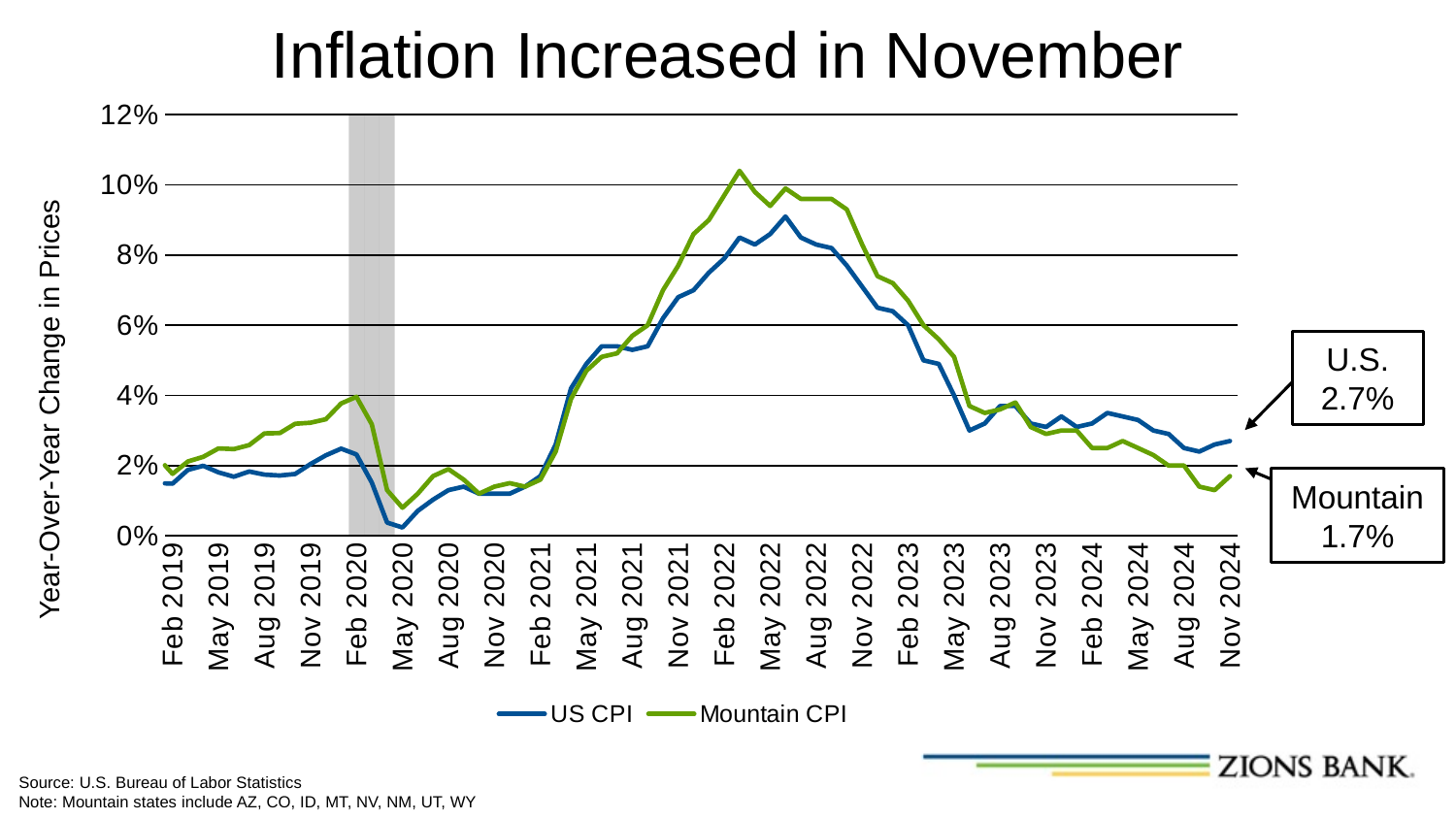
Is the peak value of the US CPI line in 2022 greater or less than 10%? less Which series reaches the higher peak on the chart? Mountain CPI Is the US CPI value around May 2020 greater or less than 2%? less How many series does the legend list? 2 What is the U.S. CPI value annotated for November 2024? 2.7% Is the peak value of the Mountain CPI line in early 2022 greater or less than 10%? greater In November 2024, which is higher, US CPI or Mountain CPI? US CPI What is the title of the chart? Inflation Increased in November What is the difference between the annotated U.S. value (2.7%) and the Mountain value (1.7%) for November 2024? 1.0 percentage points What kind of chart is shown on the slide? line chart What is the Mountain CPI value annotated for November 2024? 1.7% Do the CPI values rise or fall between mid-2022 and mid-2023? fall